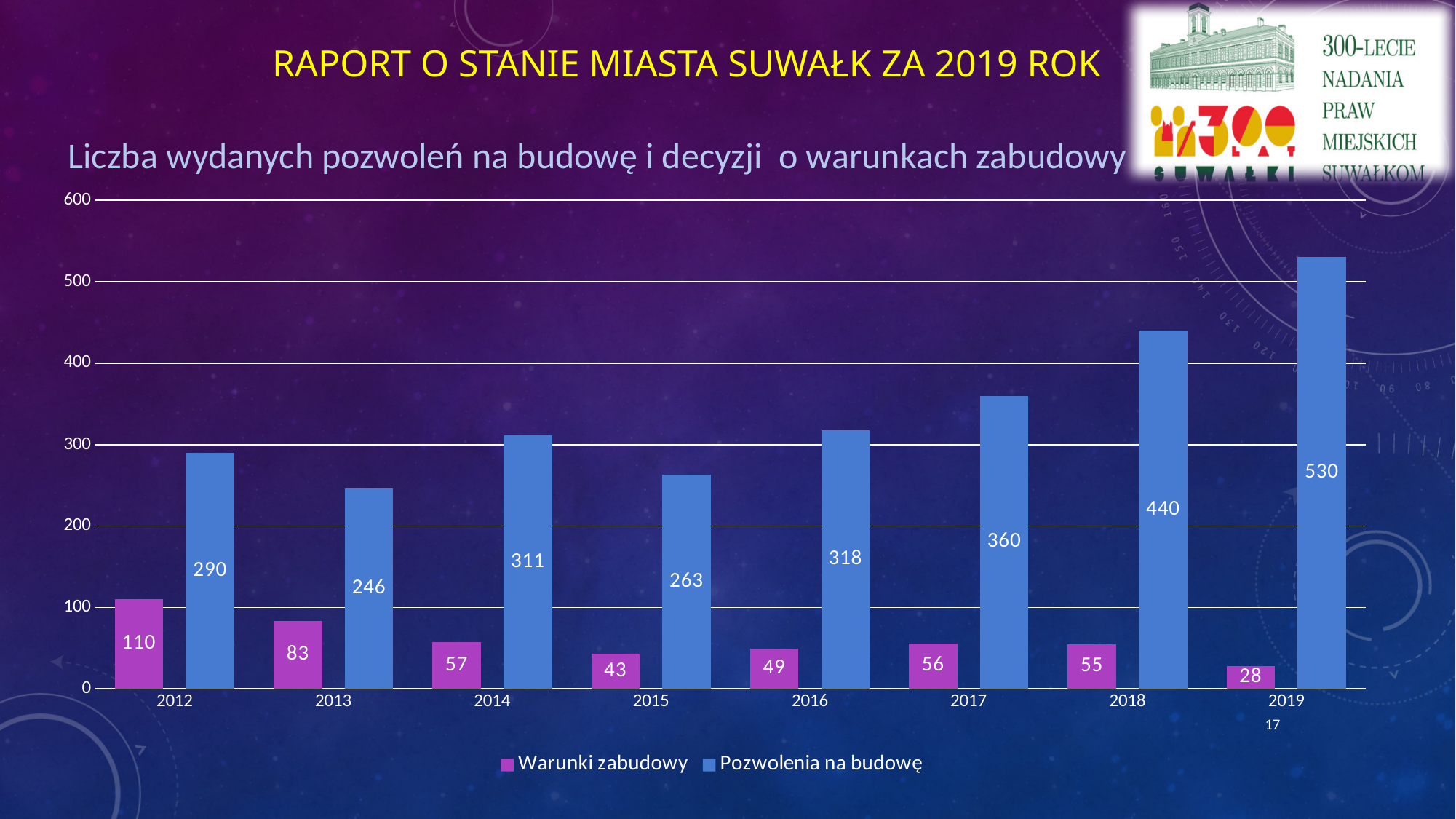
What colour are the bars for Warunki zabudowy? purple Which year has the highest value for Pozwolenia na budowę? 2019 Is the value for Pozwolenia na budowę in 2017 greater or less than 300? greater What is the difference between Pozwolenia na budowę in 2019 and 2018? 90 What is the value of Pozwolenia na budowę for 2019? 530 What is the value of Pozwolenia na budowę for 2015? 263 What kind of chart is shown on the slide? bar chart Which is larger: Warunki zabudowy in 2013 or in 2014? 2013 Which year has the lowest value for Warunki zabudowy? 2019 How many series does the legend list? 2 What is the value of Warunki zabudowy for 2012? 110 How many years are shown on the x axis? 8